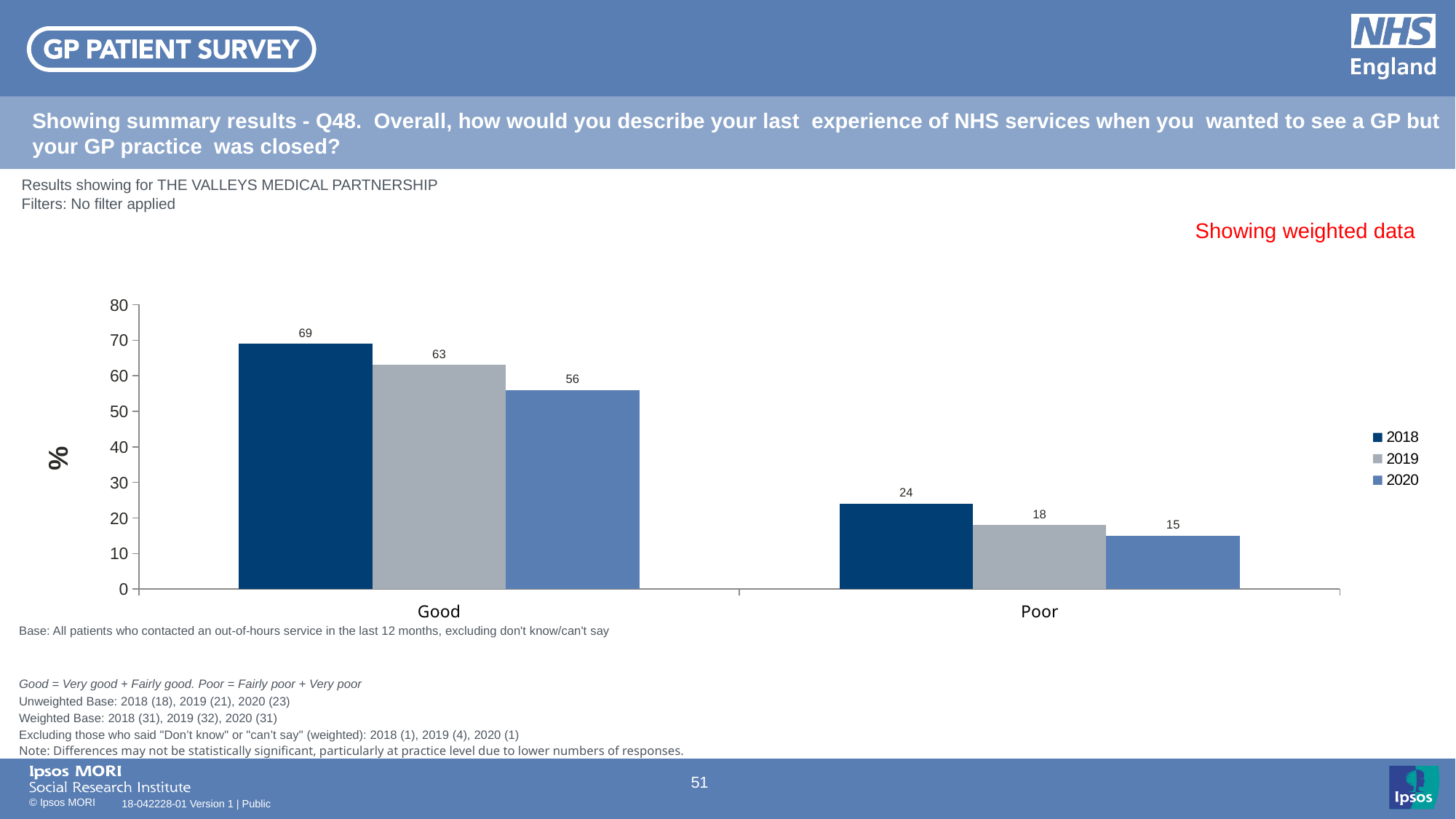
What kind of chart is shown on the slide? Bar chart What is the value for Poor in 2020? 15 How many series does the legend list? 3 What is the difference between the Good values for 2018 and 2020? 13 What is the value for Good in 2019? 63 What is the difference between the Poor values for 2018 and 2019? 6 Which year has the lowest value for Poor? 2020 Which year has the highest value for Good? 2018 Which is larger: the 2020 value for Good or the 2018 value for Poor? 2020 value for Good What is the value for Good in 2018? 69 Do the Good values rise or fall from 2018 to 2020? Fall What is the value for Poor in 2019? 18